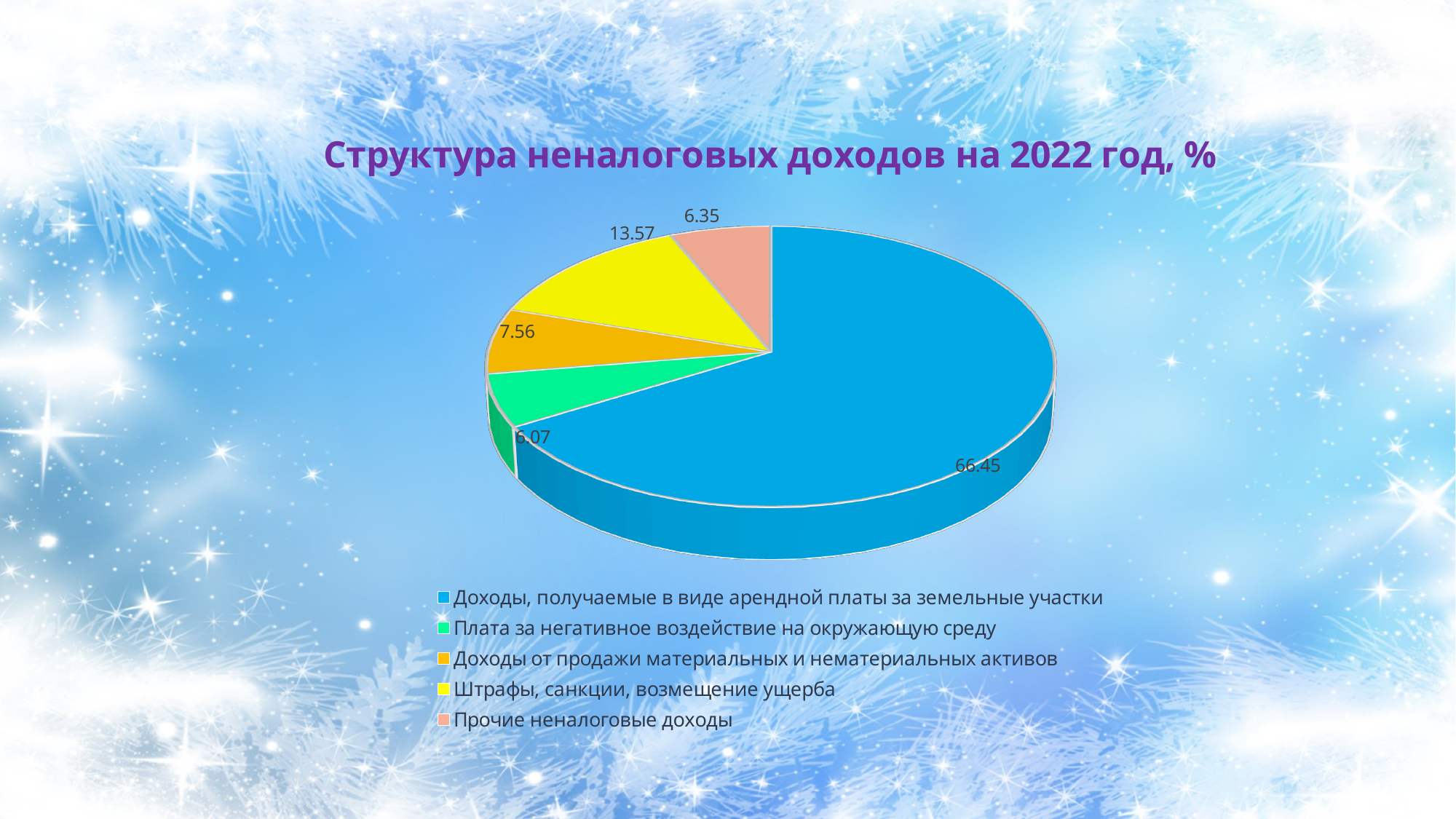
How many categories does the legend list? 5 What is the value for 'Доходы от продажи материальных и нематериальных активов'? 7.56 What is the value for 'Доходы, получаемые в виде арендной платы за земельные участки'? 66.45 What is the value for 'Штрафы, санкции, возмещение ущерба'? 13.57 What type of chart is shown on the slide? Pie chart What is the value for 'Прочие неналоговые доходы'? 6.35 Which is larger: 'Прочие неналоговые доходы' or 'Плата за негативное воздействие на окружающую среду'? Прочие неналоговые доходы What is the difference between the values for 'Штрафы, санкции, возмещение ущерба' and 'Доходы от продажи материальных и нематериальных активов'? 6.01 Which category has the largest share of the pie? Доходы, получаемые в виде арендной платы за земельные участки Which category has the smallest share of the pie? Плата за негативное воздействие на окружающую среду What is the value for 'Плата за негативное воздействие на окружающую среду'? 6.07 What is the title of the chart? Структура неналоговых доходов на 2022 год, %